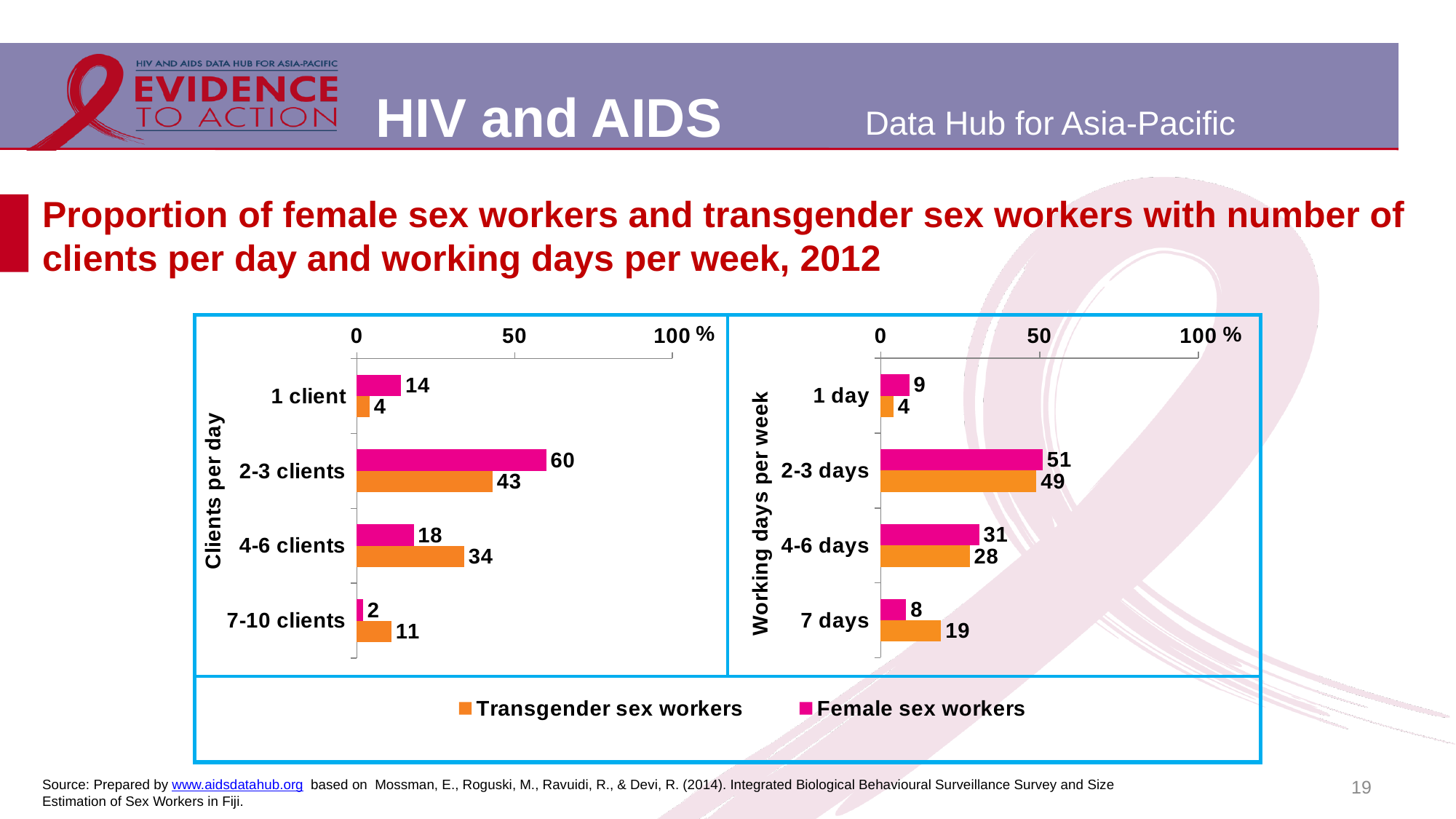
What kind of chart is the left chart (Clients per day)? Bar chart In the left chart (Clients per day), what is the value for female sex workers with 2-3 clients? 60 In the left chart (Clients per day), which category has the lowest value for transgender sex workers? 1 client In the right chart (Working days per week), what is the value for female sex workers working 1 day? 9 In the left chart (Clients per day), what is the value for transgender sex workers with 4-6 clients? 34 In the left chart (Clients per day), which is larger for 7-10 clients: female sex workers or transgender sex workers? Transgender sex workers How many categories are shown in the right chart (Working days per week)? 4 In the left chart (Clients per day), which category has the highest value for female sex workers? 2-3 clients How many series does the legend list? 2 In the right chart (Working days per week), is the value for female sex workers working 2-3 days greater or less than 50? greater In the right chart (Working days per week), what is the difference between female sex workers and transgender sex workers for 2-3 days? 2 In the right chart (Working days per week), what is the value for transgender sex workers working 7 days? 19